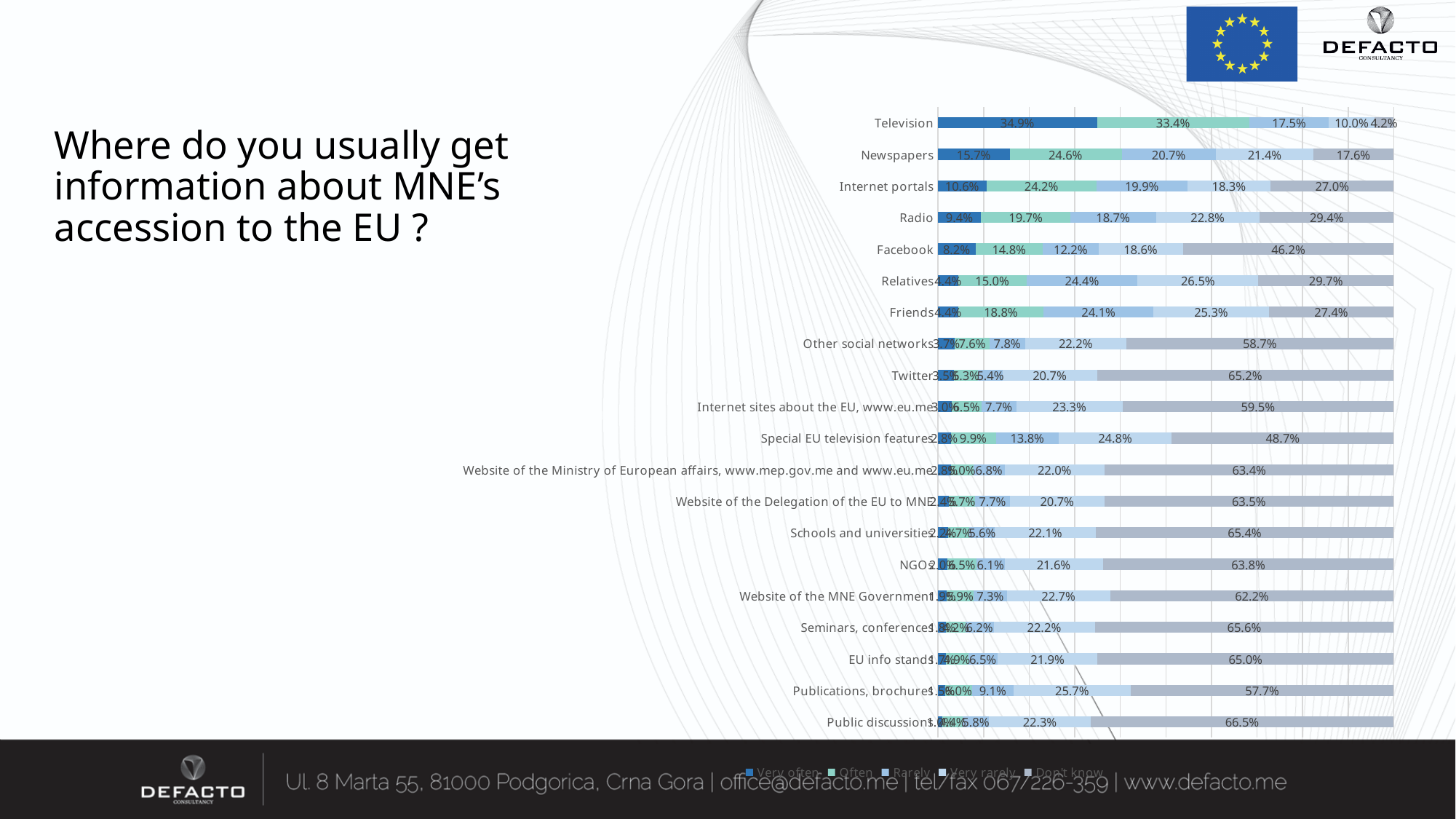
What percentage of respondents said they get information about MNE's EU accession from Television 'Very often'? 34.9% What is the 'Don't know' value for Facebook? 46.2% What is the 'Often' value for Newspapers? 24.6% What is the difference between the 'Often' and 'Rarely' values for Newspapers? 3.9 percentage points How many information sources are listed on the chart? 20 What is the first series listed in the legend? Very often Which has a larger 'Don't know' value, Radio or Internet portals? Radio Which source has the highest 'Don't know' value? Public discussions What is the total of the Television bar? 100.0% What kind of chart is shown on the slide? Stacked bar chart How many series does the legend list? 5 Which source has the highest 'Very often' value? Television